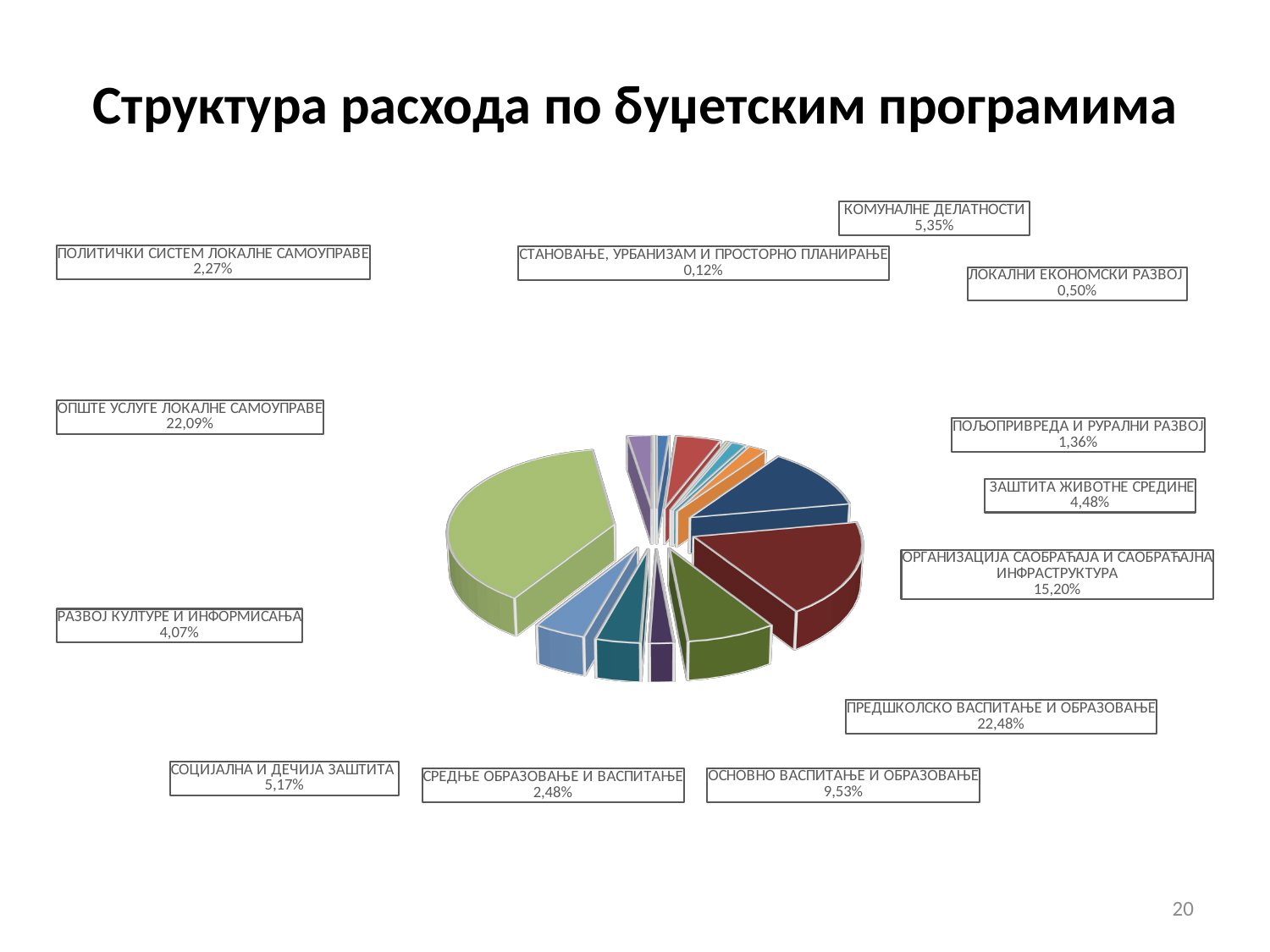
What is the difference in percentage points between ПРЕДШКОЛСКО ВАСПИТАЊЕ И ОБРАЗОВАЊЕ and ОПШТЕ УСЛУГЕ ЛОКАЛНЕ САМОУПРАВЕ? 0,39 Which has the larger share, КОМУНАЛНЕ ДЕЛАТНОСТИ or СОЦИЈАЛНА И ДЕЧИЈА ЗАШТИТА? КОМУНАЛНЕ ДЕЛАТНОСТИ What is the value shown for ЛОКАЛНИ ЕКОНОМСКИ РАЗВОЈ? 0,50% What kind of chart is shown on the slide? Pie chart What is the title of the chart on the slide? Структура расхода по буџетским програмима What share does ОРГАНИЗАЦИЈА САОБРАЋАЈА И САОБРАЋАЈНА ИНФРАСТРУКТУРА have? 15,20% What is the difference in percentage points between ОРГАНИЗАЦИЈА САОБРАЋАЈА И САОБРАЋАЈНА ИНФРАСТРУКТУРА and ОСНОВНО ВАСПИТАЊЕ И ОБРАЗОВАЊЕ? 5,67 What is the value shown for ОСНОВНО ВАСПИТАЊЕ И ОБРАЗОВАЊЕ? 9,53% What share does ПРЕДШКОЛСКО ВАСПИТАЊЕ И ОБРАЗОВАЊЕ have in the pie chart? 22,48%